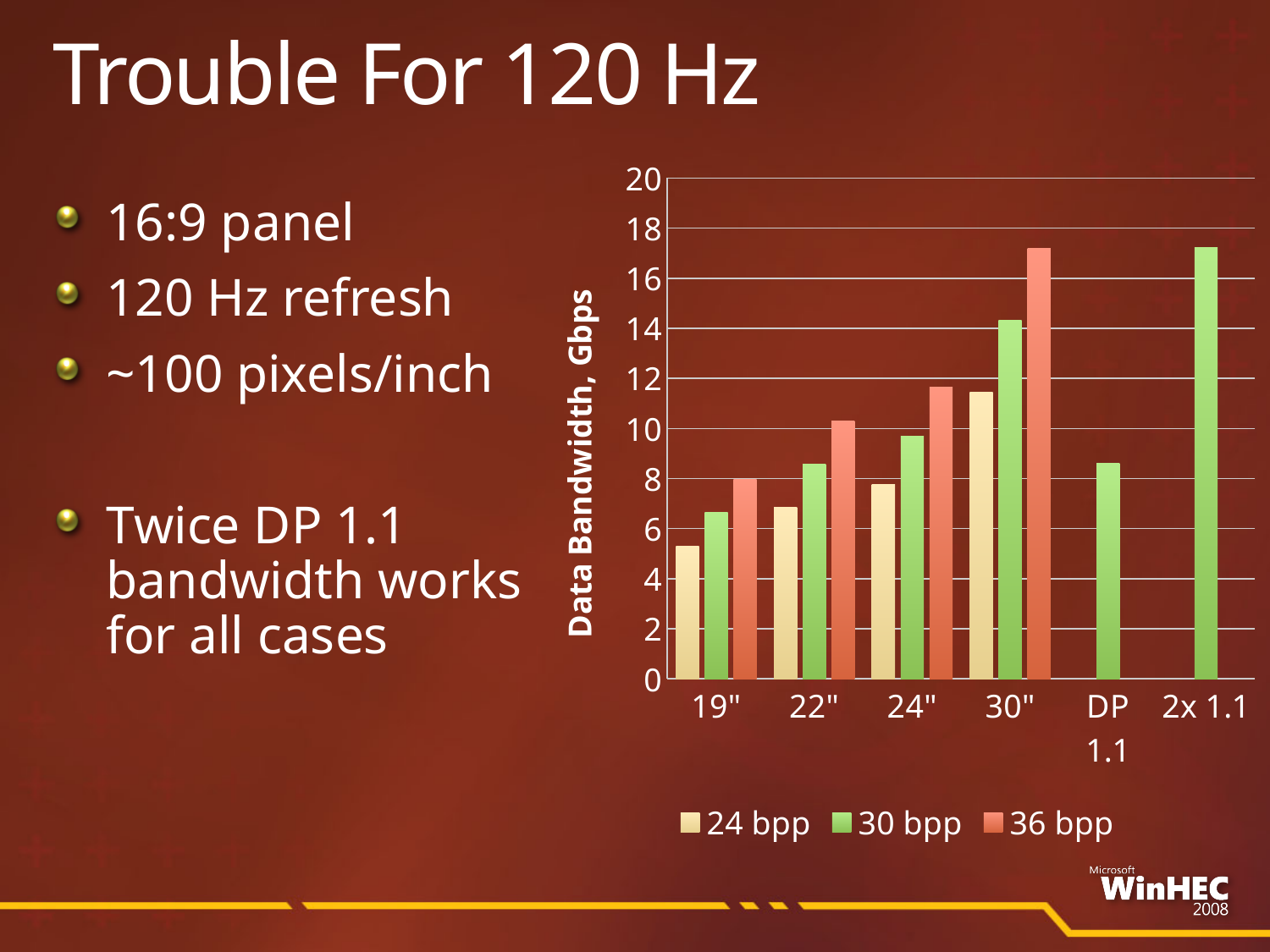
What is the label of the vertical axis of the chart? Data Bandwidth, Gbps Which category has the lowest 24 bpp value? 19" Which series in the legend is shown in green? 30 bpp Is the value for DP 1.1 greater or less than 10? less Which is larger: the 30 bpp value for 30" or the 36 bpp value for 24"? 30 bpp value for 30" How many categories are shown along the x axis of the chart? 6 Is the 24 bpp value for 19" greater or less than 6? less Among the panel sizes, which category has the highest 36 bpp value? 30" How many series does the chart legend list? 3 Is the 36 bpp value for 24" greater or less than 10? greater What kind of chart is shown on the slide? bar chart